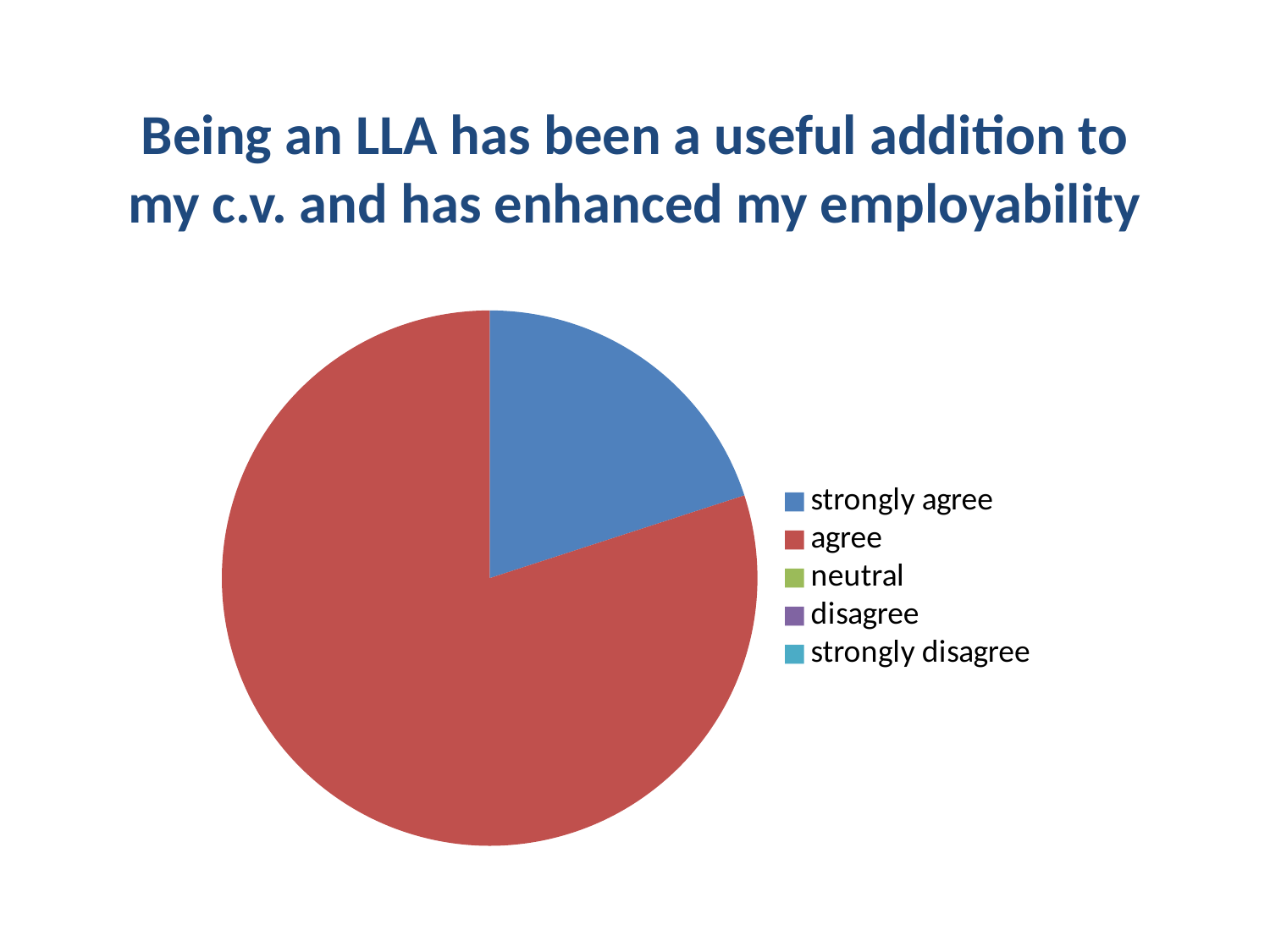
What is the title of the chart? Being an LLA has been a useful addition to my c.v. and has enhanced my employability What kind of chart is shown on the slide? pie chart What colour is the slice for agree? red How many entries does the legend list? 5 Does the slice for agree take up more or less than half of the pie? more Of the two visible slices, which one is smaller? strongly agree Which category takes up the largest share of the pie? agree Which is larger, the slice for agree or the slice for strongly agree? agree How many slices are visible in the pie? 2 Does the slice for strongly agree take up more or less than half of the pie? less